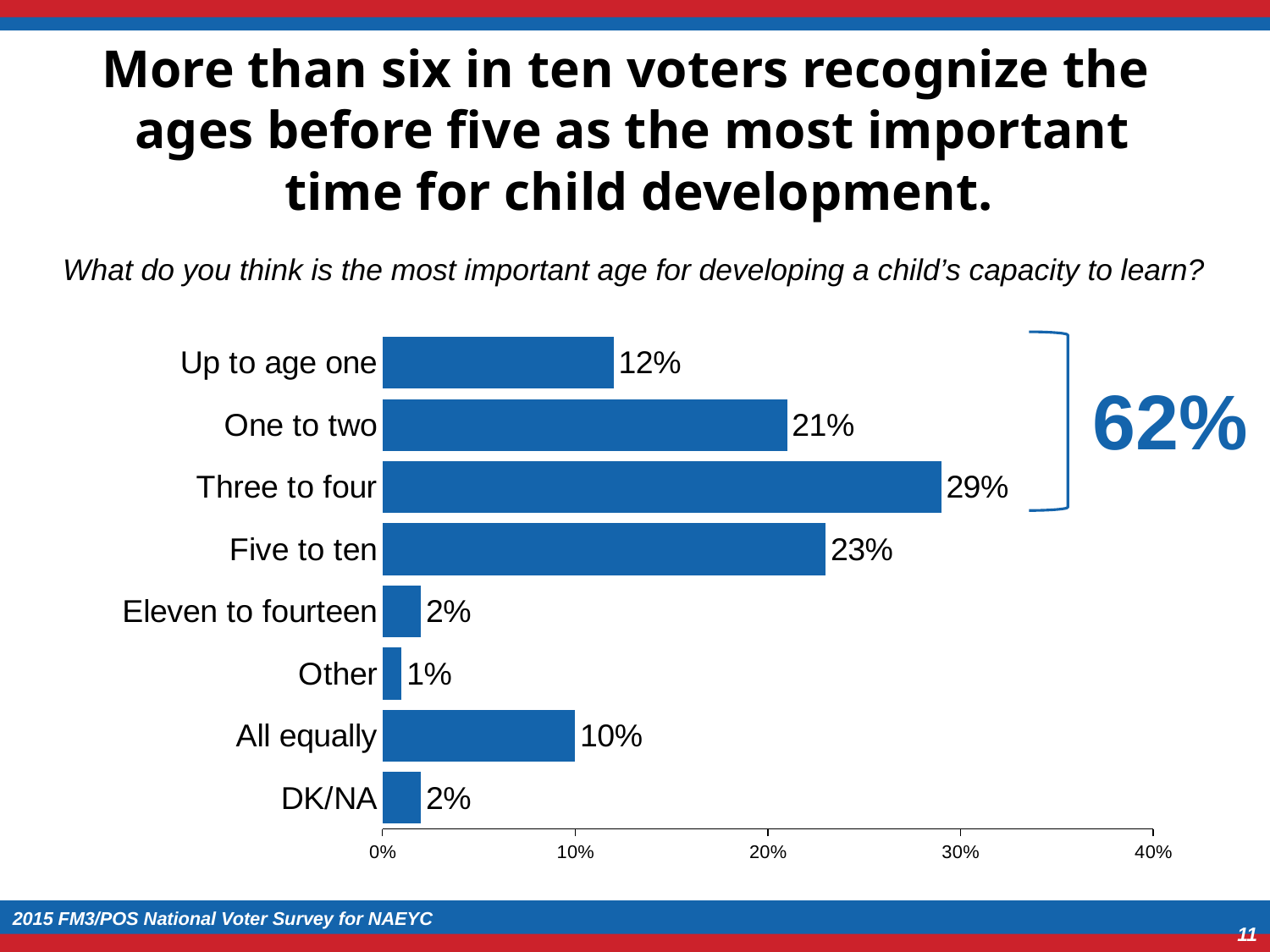
What percentage of voters chose "Three to four" as the most important age? 29% How many categories are shown in the chart? 8 Which category has the highest value in the chart? Three to four What is the value shown for "All equally"? 10% Which category has the lowest value in the chart? Other What percentage is shown for "Up to age one"? 12% Which is larger, the value for "One to two" or the value for "Five to ten"? Five to ten Is the value for "One to two" greater or less than 20%? greater What kind of chart is shown on the slide? Bar chart What is the combined total of "Up to age one", "One to two" and "Three to four" as indicated by the bracket? 62% What is the highest value shown on the horizontal axis? 40% What is the difference between the values for "Three to four" and "Five to ten"? 6%